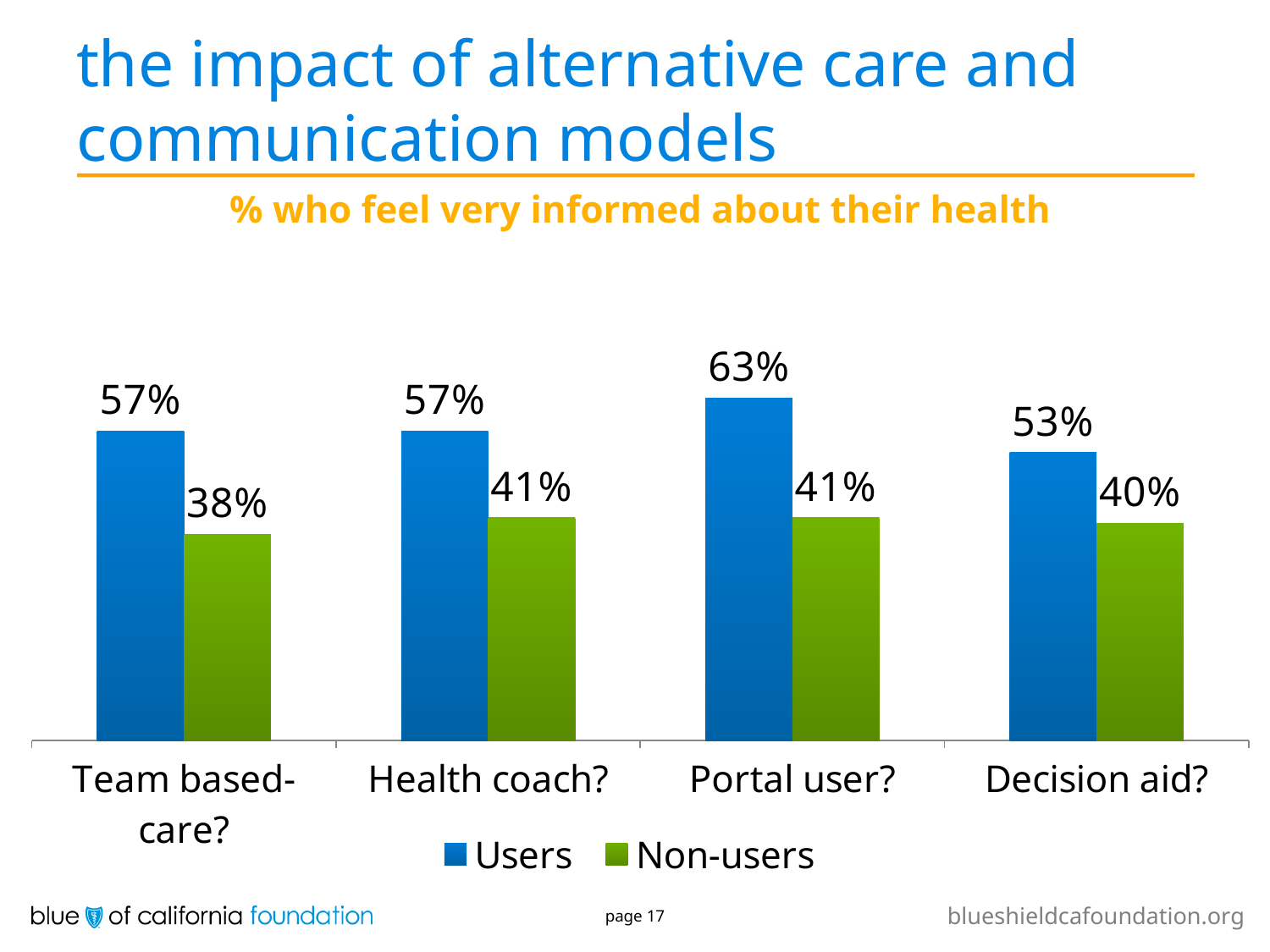
How many series does the legend list? 2 What is the difference between Users and Non-users in the Team based-care? category? 19% Which category has the lowest value for Non-users? Team based-care? What is the value for Non-users in the Health coach? category? 41% How many categories are shown on the x axis? 4 What is the difference between Users and Non-users in the Portal user? category? 22% What kind of chart is shown on the slide? Bar chart What is the value for Non-users in the Team based-care? category? 38% What is the value for Users in the Portal user? category? 63% What is the value for Users in the Decision aid? category? 53% Which category has the highest value for Users? Portal user? Which is larger: the Users value for Decision aid? or the Users value for Health coach? Health coach?